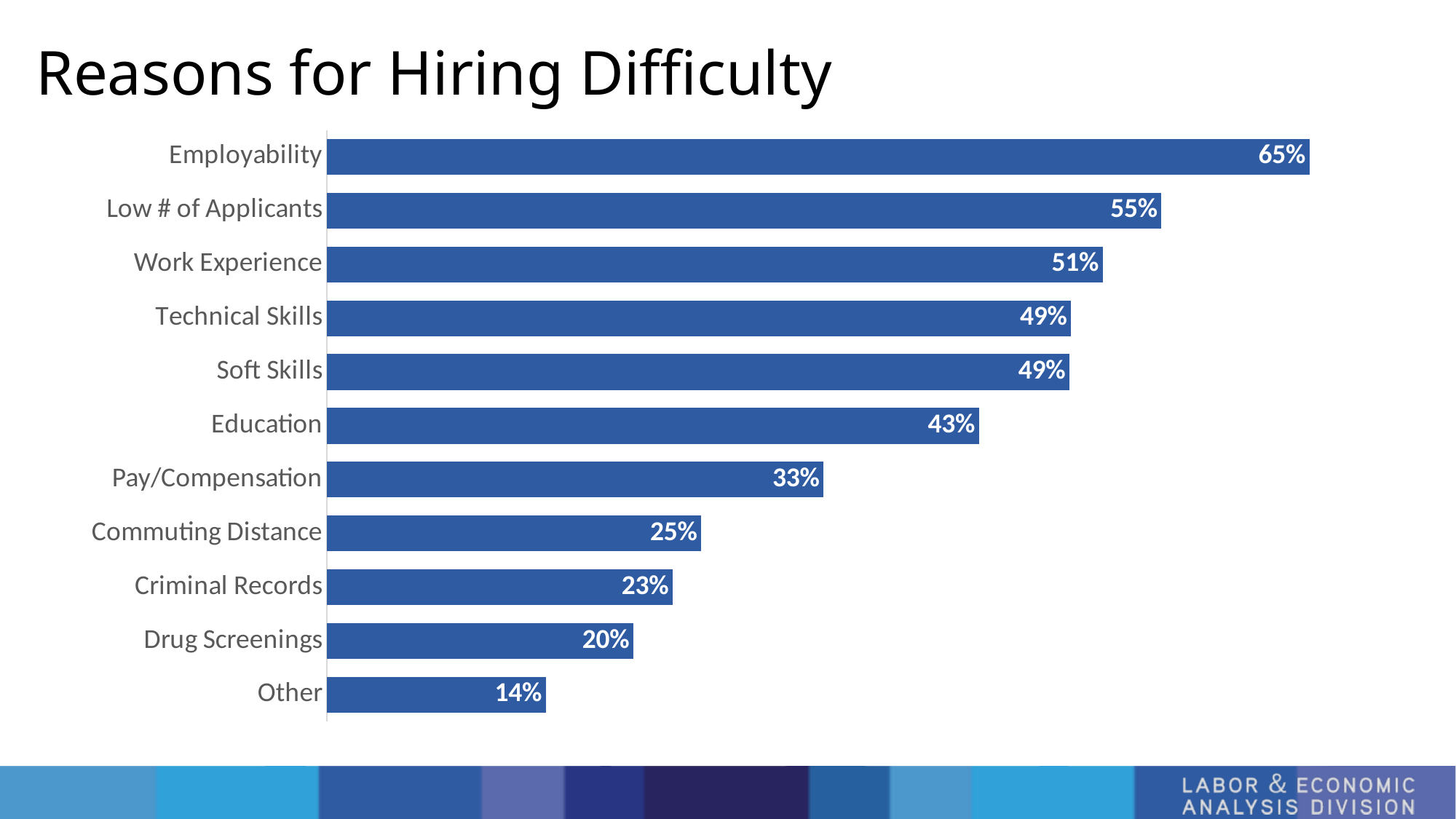
Which category has the lowest value? Other Which category has the highest value? Employability What is the value for Employability? 65% How many categories are shown in the chart? 11 Which is larger, the value for Criminal Records or the value for Commuting Distance? Commuting Distance Which is larger, the value for Work Experience or the value for Education? Work Experience What is the difference between the values for Employability and Low # of Applicants? 10% What is the difference between the values for Education and Commuting Distance? 18% What kind of chart is shown on the slide? Bar chart What is the value for Drug Screenings? 20% What is the title of the chart? Reasons for Hiring Difficulty What is the value for Pay/Compensation? 33%